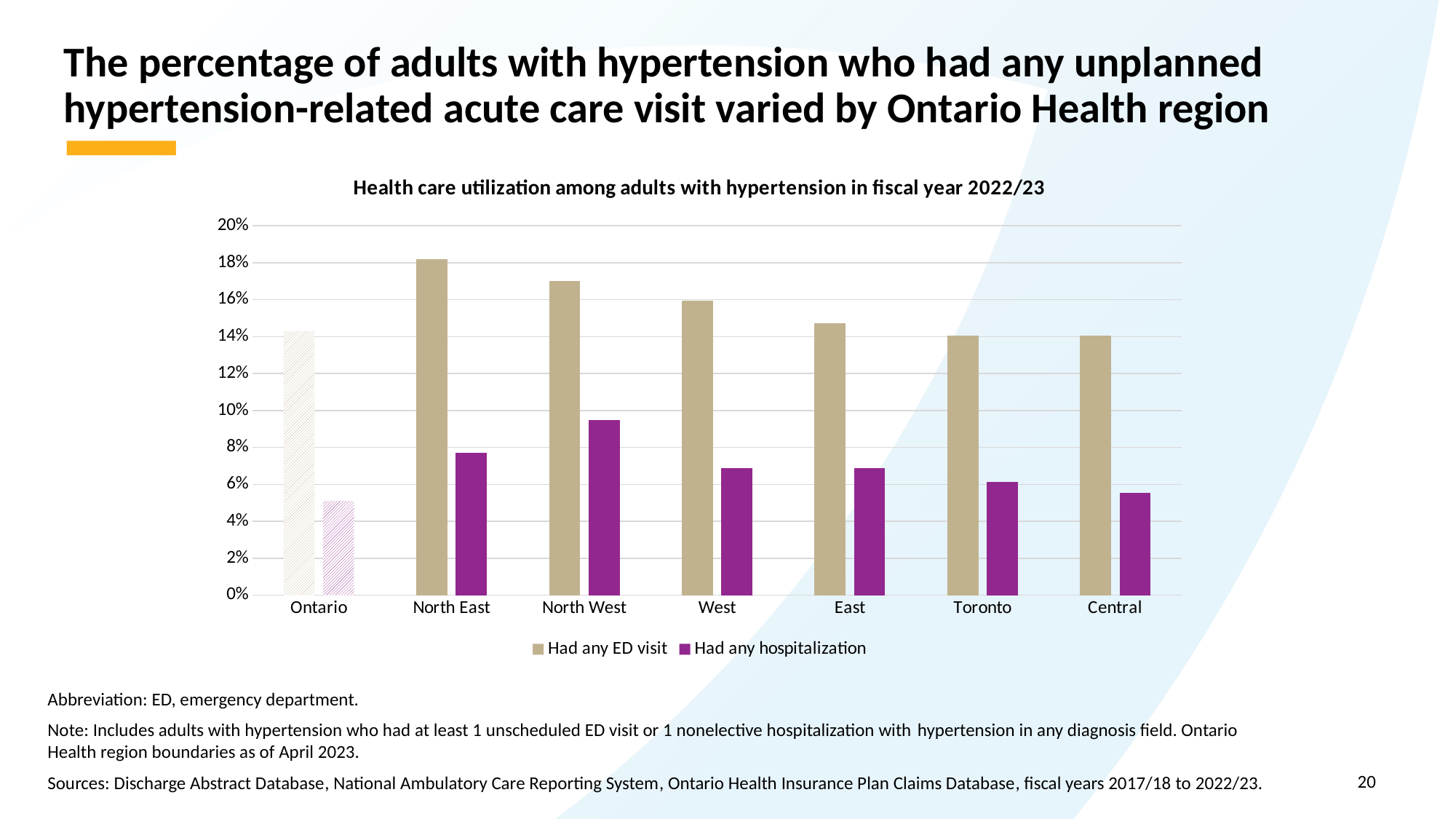
Which category has the highest value for 'Had any ED visit'? North East Is the 'Had any hospitalization' value for Toronto greater or less than 8%? less Which category has the highest value for 'Had any hospitalization'? North West Is the 'Had any hospitalization' value for North West greater or less than 8%? greater Is the 'Had any ED visit' value for North East greater or less than 16%? greater Which is larger: the 'Had any ED visit' value for West or for East? West How many categories are shown along the x axis? 7 Which is larger: the 'Had any hospitalization' value for North West or for North East? North West What is the title of the chart? Health care utilization among adults with hypertension in fiscal year 2022/23 How many series does the legend list? 2 What kind of chart is shown on the slide? Bar chart